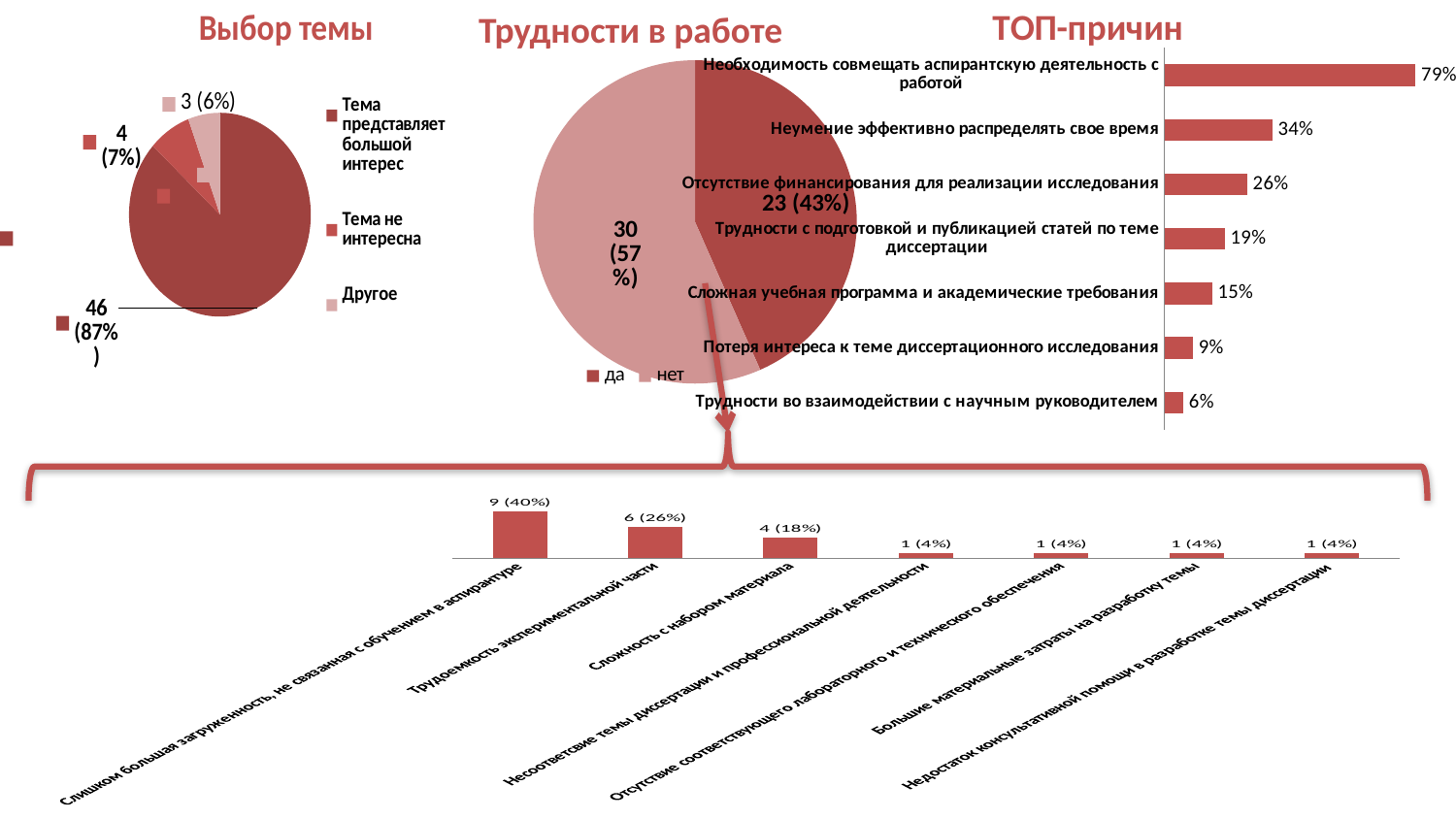
In the 'Выбор темы' pie chart, what value is shown for 'Тема представляет большой интерес'? 46 (87%) In the 'Выбор темы' pie chart, what share of the pie does 'Другое' take? 6% In the 'ТОП-причин' chart, what is the difference between the values for 'Отсутствие финансирования для реализации исследования' and 'Потеря интереса к теме диссертационного исследования'? 17% What kind of chart is the 'ТОП-причин' chart? Bar chart In the 'Выбор темы' pie chart, how many slices are there? 3 In the 'ТОП-причин' chart, what is the value for 'Неумение эффективно распределять свое время'? 34% In the 'Трудности в работе' pie chart, which slice is larger, 'да' or 'нет'? нет In the bar chart at the bottom of the slide, what is the value for 'Трудоемкость экспериментальной части'? 6 (26%) In the 'Трудности в работе' pie chart, what value is shown for 'да'? 23 (43%) In the 'ТОП-причин' chart, which category has the highest value? Необходимость совмещать аспирантскую деятельность с работой In the bar chart at the bottom of the slide, how many categories are shown? 7 In the 'ТОП-причин' chart, which category has the lowest value? Трудности во взаимодействии с научным руководителем